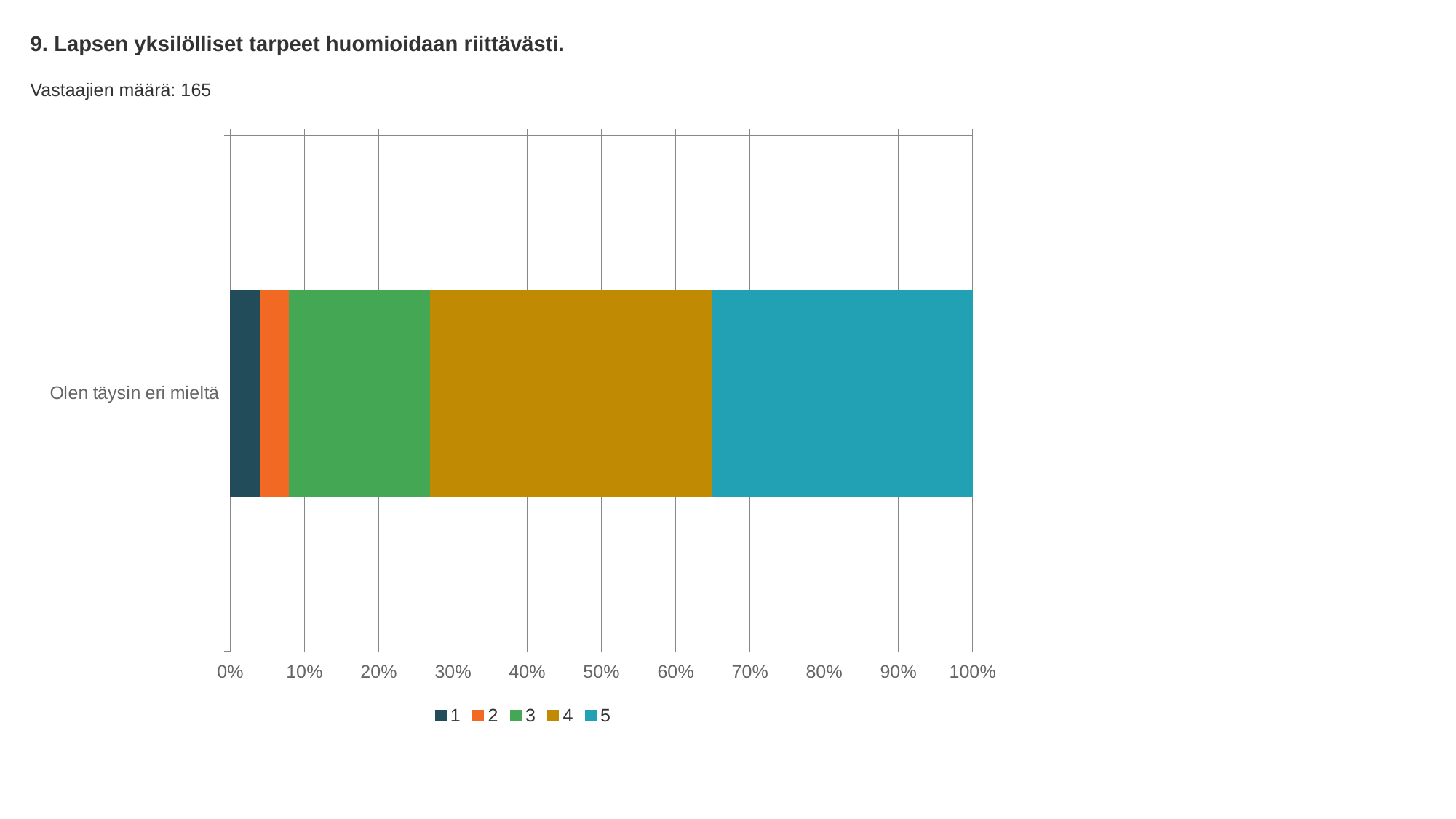
How many respondents (Vastaajien määrä) are reported on the slide? 165 How many series does the legend list? 5 Which is larger in the bar: the segment for series 3 or the segment for series 2? 3 Is the share for series 1 greater or less than 10%? less Is the share for series 5 greater or less than 30%? greater Is the share for series 4 greater or less than 30%? greater Which is larger in the bar: the segment for series 4 or the segment for series 3? 4 What is the title of the chart? 9. Lapsen yksilölliset tarpeet huomioidaan riittävästi. What kind of chart is shown on the slide? Stacked bar chart Which is larger in the bar: the segment for series 5 or the segment for series 1? 5 How many bars (categories) are plotted in the chart? 1